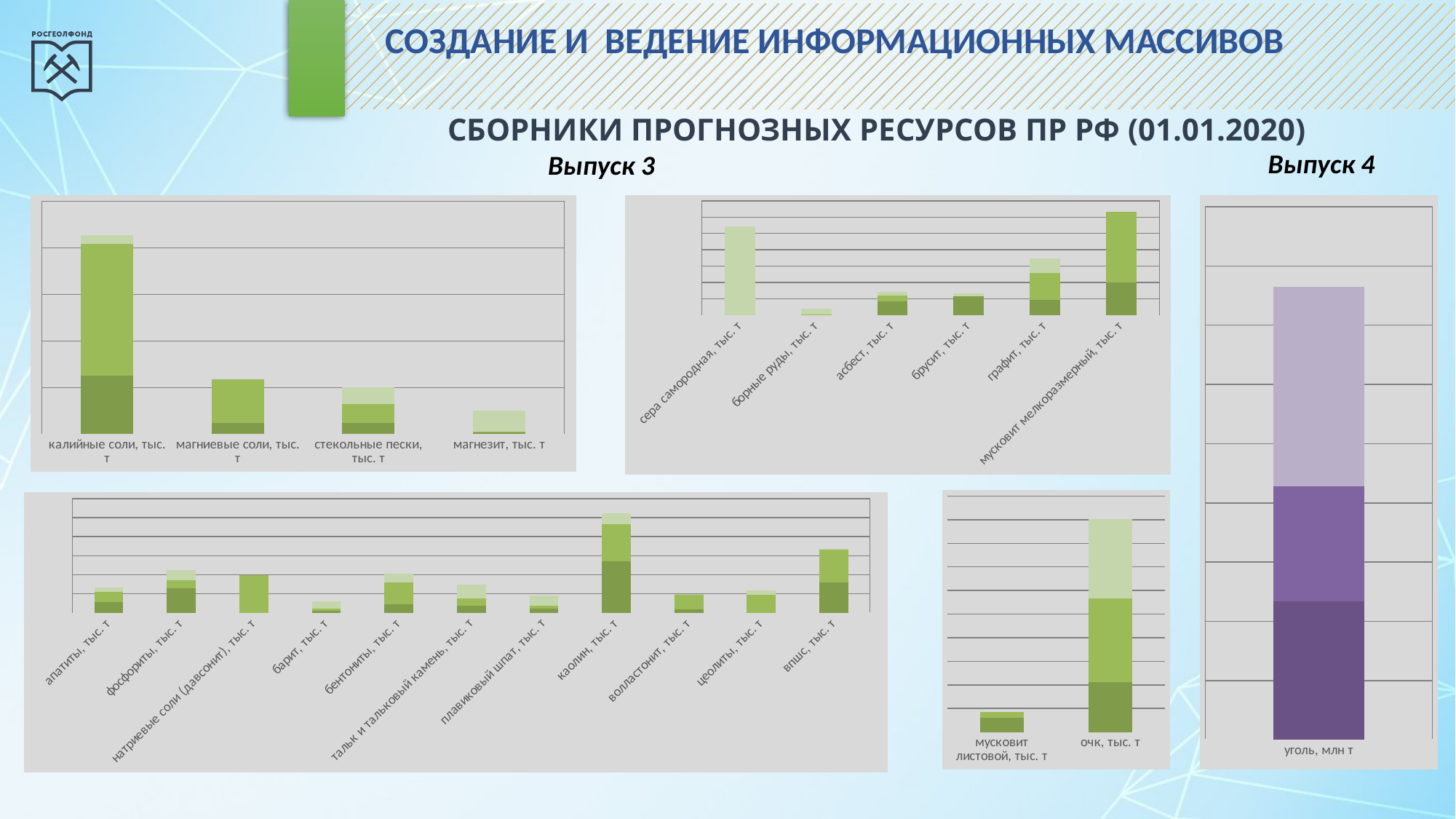
What kind of chart is the top-left chart under Выпуск 3 (the one with калийные соли)? bar chart In the top-left chart under Выпуск 3, which category has the tallest bar? калийные соли, тыс. т In the top-middle chart (the one with сера самородная), which category has the tallest bar? мусковит мелкоразмерный, тыс. т In the top-left chart under Выпуск 3, which category has the shortest bar? магнезит, тыс. т What is the category label on the x axis of the chart under Выпуск 4? уголь, млн т In the bottom-left chart (the one with апатиты), how many categories are shown on the x axis? 11 In the bottom-left chart, which bar is taller: каолин or впшс? каолин In the top-left chart under Выпуск 3, how many categories are shown on the x axis? 4 In the bottom-left chart (the one with апатиты), which category has the tallest bar? каолин, тыс. т In the bottom-middle chart, which bar is taller: мусковит листовой or очк? очк In the top-middle chart (the one with сера самородная), which category has the shortest bar? борные руды, тыс. т In the top-middle chart (the one with сера самородная), how many categories are shown? 6